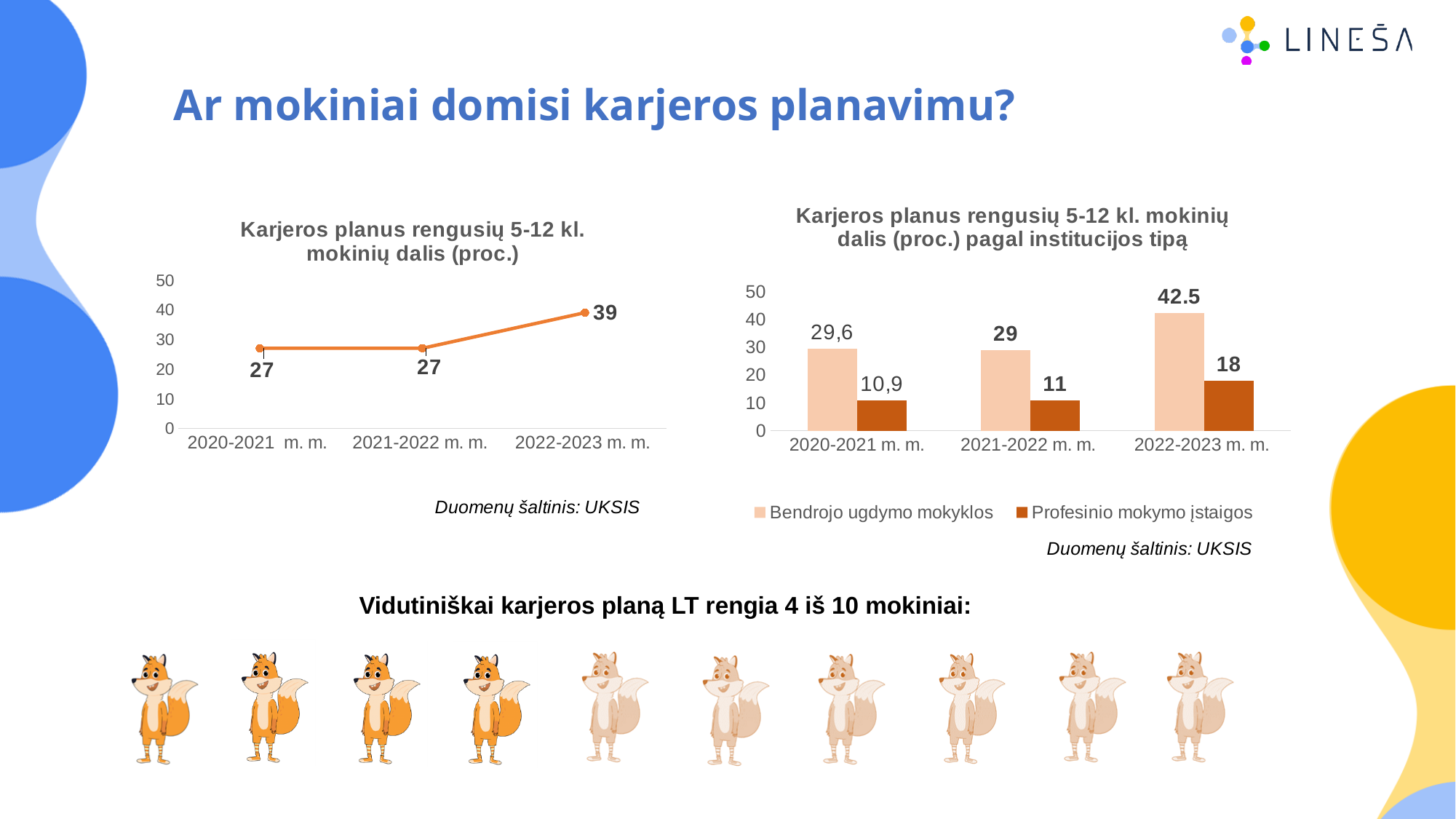
In the left chart (Karjeros planus rengusių 5-12 kl. mokinių dalis), how many school years are plotted? 3 In the right chart (pagal institucijos tipą), which is larger in 2021-2022 m. m.: Bendrojo ugdymo mokyklos or Profesinio mokymo įstaigos? Bendrojo ugdymo mokyklos In the left chart (Karjeros planus rengusių 5-12 kl. mokinių dalis), what is the value for 2022-2023 m. m.? 39 In the right chart (pagal institucijos tipą), what is the value for Profesinio mokymo įstaigos in 2020-2021 m. m.? 10,9 In the left chart (Karjeros planus rengusių 5-12 kl. mokinių dalis), by how much did the value increase from 2021-2022 m. m. to 2022-2023 m. m.? 12 In the left chart (Karjeros planus rengusių 5-12 kl. mokinių dalis), what is the value for 2020-2021 m. m.? 27 In the left chart (Karjeros planus rengusių 5-12 kl. mokinių dalis), what kind of chart is shown? line chart In the right chart (pagal institucijos tipą), what is the difference between Bendrojo ugdymo mokyklos and Profesinio mokymo įstaigos in 2021-2022 m. m.? 18 In the right chart (pagal institucijos tipą), what kind of chart is shown? bar chart In the right chart (pagal institucijos tipą), how many series does the legend list? 2 In the right chart (pagal institucijos tipą), what is the value for Bendrojo ugdymo mokyklos in 2022-2023 m. m.? 42.5 In the right chart (pagal institucijos tipą), which school year has the highest value for Profesinio mokymo įstaigos? 2022-2023 m. m.